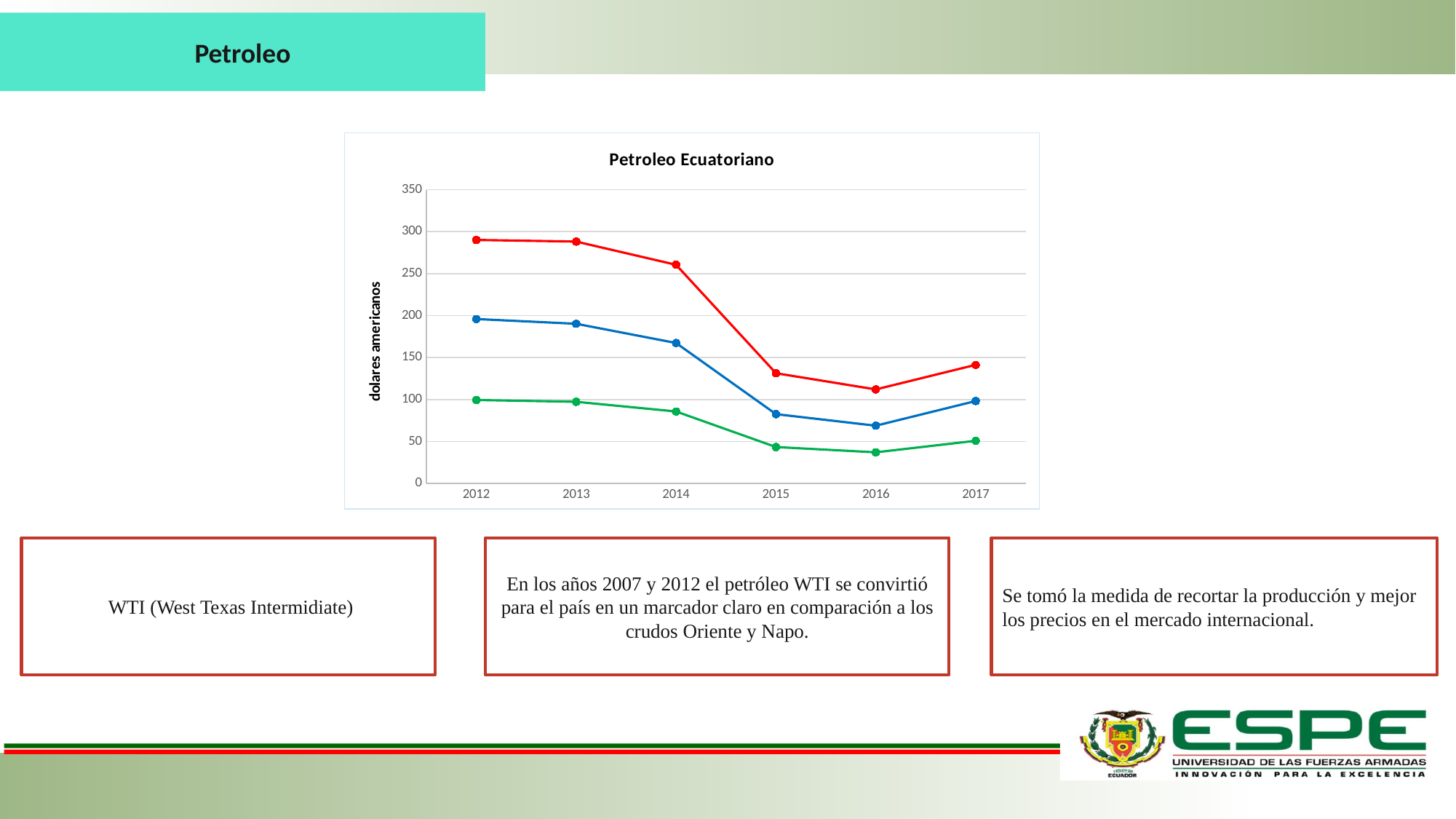
Is the value of the red line in 2016 greater or less than 150? less Is the value of the red line in 2012 greater or less than 250? greater Is the value of the blue line larger in 2016 or in 2017? 2017 What is the title of the chart? Petroleo Ecuatoriano Is the value of the blue line in 2014 greater or less than 150? greater How many lines are plotted on the chart? 3 What kind of chart is shown on the slide? line chart In which year does the red line reach its lowest value? 2016 Do the values of the green line rise or fall from 2012 to 2016? fall What is the label on the vertical axis of the chart? dolares americanos How many years are shown along the x axis of the chart? 6